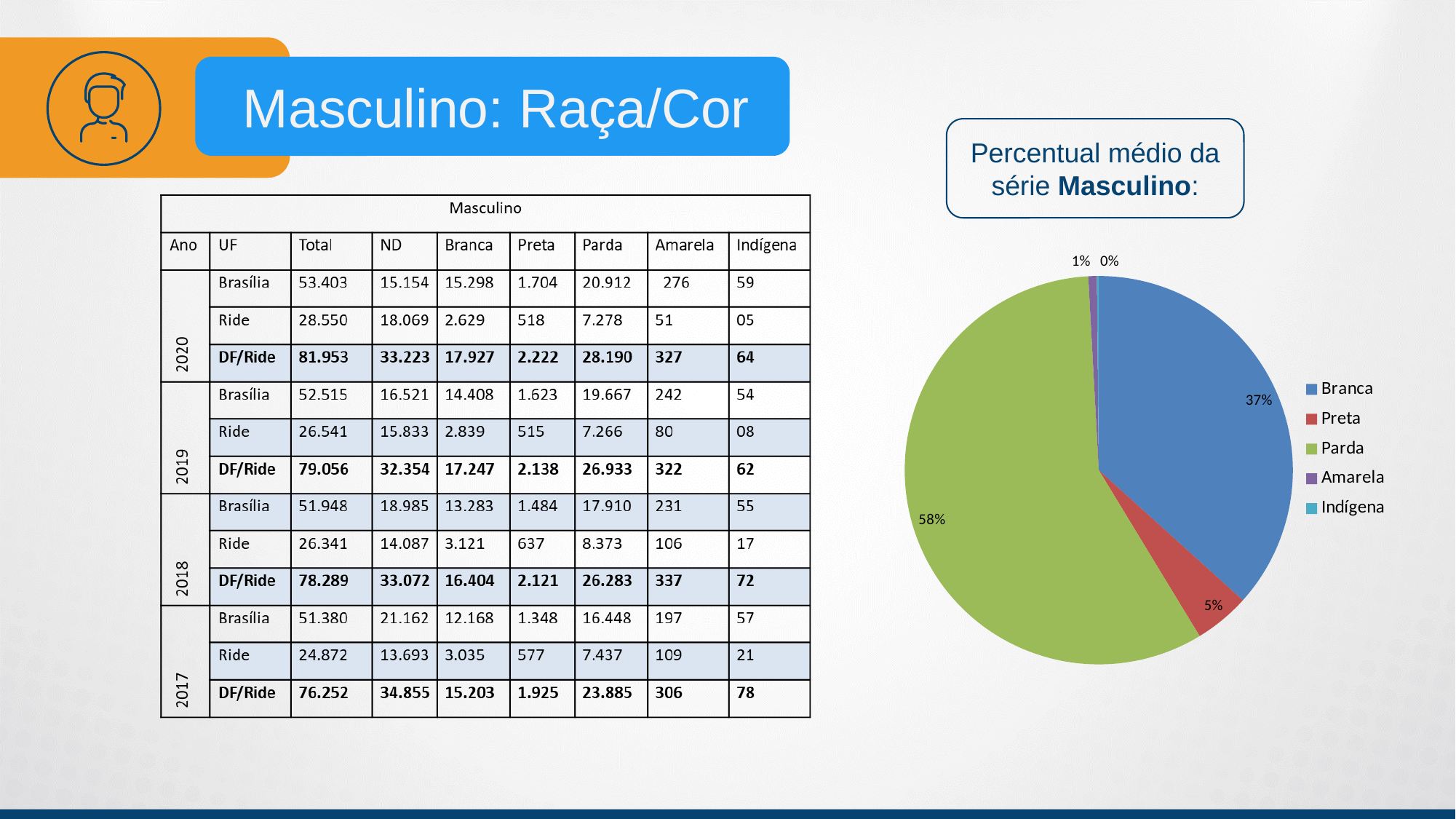
What colour is the Parda slice in the pie chart? green In the pie chart, which is larger, the Branca slice or the Preta slice? Branca In the pie chart, what percentage is shown for Preta? 5% In the pie chart, what percentage is shown for Parda? 58% How many categories does the legend of the pie chart list? 5 In the pie chart, what percentage is shown for Indígena? 0% What type of chart is shown on the right side of the slide? pie chart In the pie chart, what is the difference in percentage points between Parda and Branca? 21 Which category has the largest slice in the pie chart? Parda Which category has the smallest slice in the pie chart? Indígena In the pie chart, what percentage is shown for Branca? 37% In the pie chart, what percentage is shown for Amarela? 1%